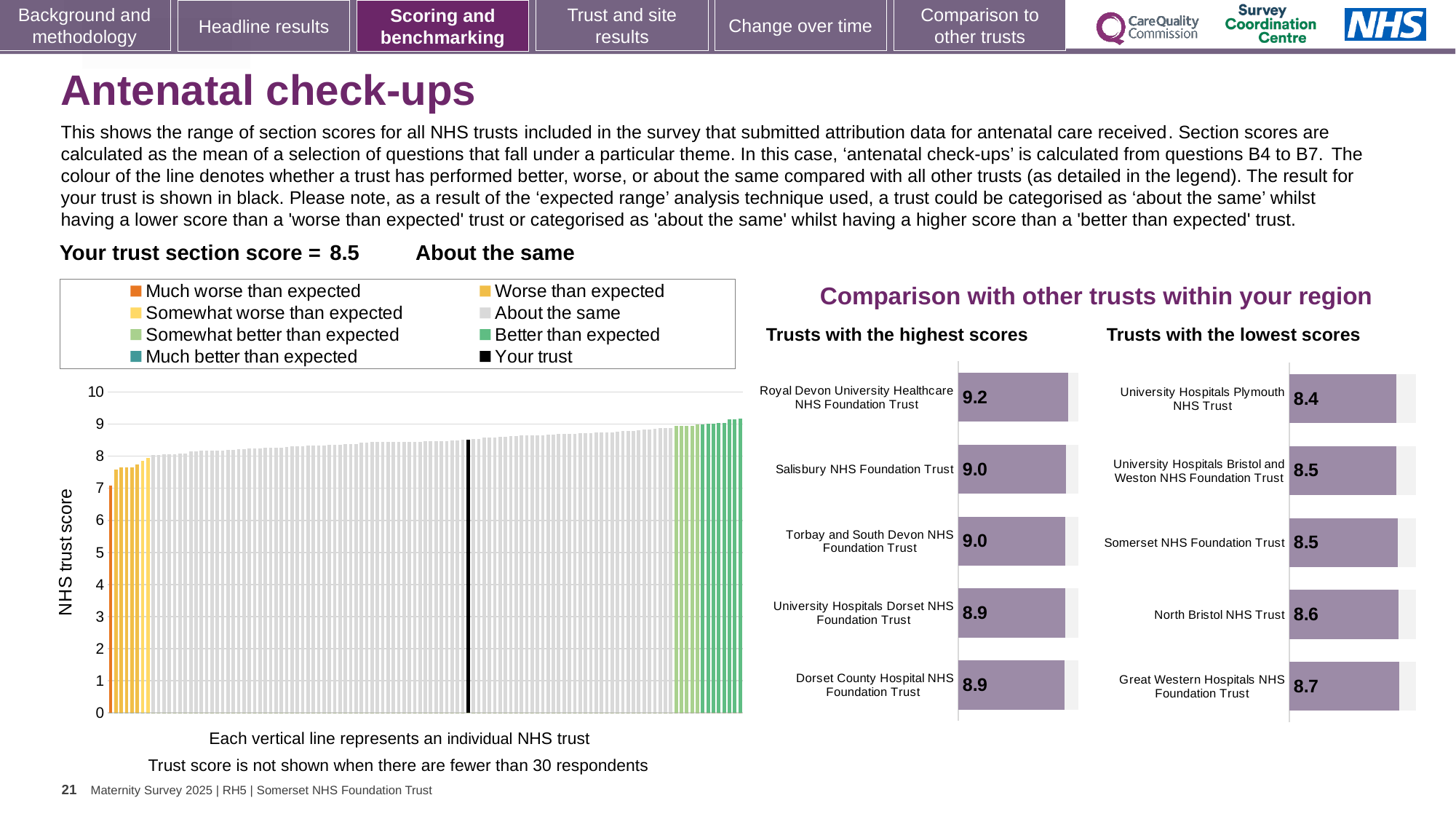
What kind of chart is the NHS trust score chart on the left of the slide? bar chart In the NHS trust score chart on the left, do the bar values rise or fall from left to right? rise In the 'Trusts with the highest scores' chart, what is the difference between the scores of Royal Devon University Healthcare NHS Foundation Trust and Dorset County Hospital NHS Foundation Trust? 0.3 In the 'Trusts with the lowest scores' chart, which trust has the lowest score? University Hospitals Plymouth NHS Trust In the 'Trusts with the highest scores' chart, which trust has the highest score? Royal Devon University Healthcare NHS Foundation Trust How many entries does the legend of the NHS trust score chart on the left list? 8 What is the y-axis title of the bar chart on the left of the slide? NHS trust score In the 'Trusts with the lowest scores' chart, which has the higher score: North Bristol NHS Trust or University Hospitals Plymouth NHS Trust? North Bristol NHS Trust In the 'Trusts with the lowest scores' chart, what is the score for Great Western Hospitals NHS Foundation Trust? 8.7 In the 'Trusts with the highest scores' chart, what is the score for Royal Devon University Healthcare NHS Foundation Trust? 9.2 How many trusts are listed in the 'Trusts with the highest scores' chart? 5 In the NHS trust score chart on the left, is the value of the black 'Your trust' bar greater or less than 5? greater